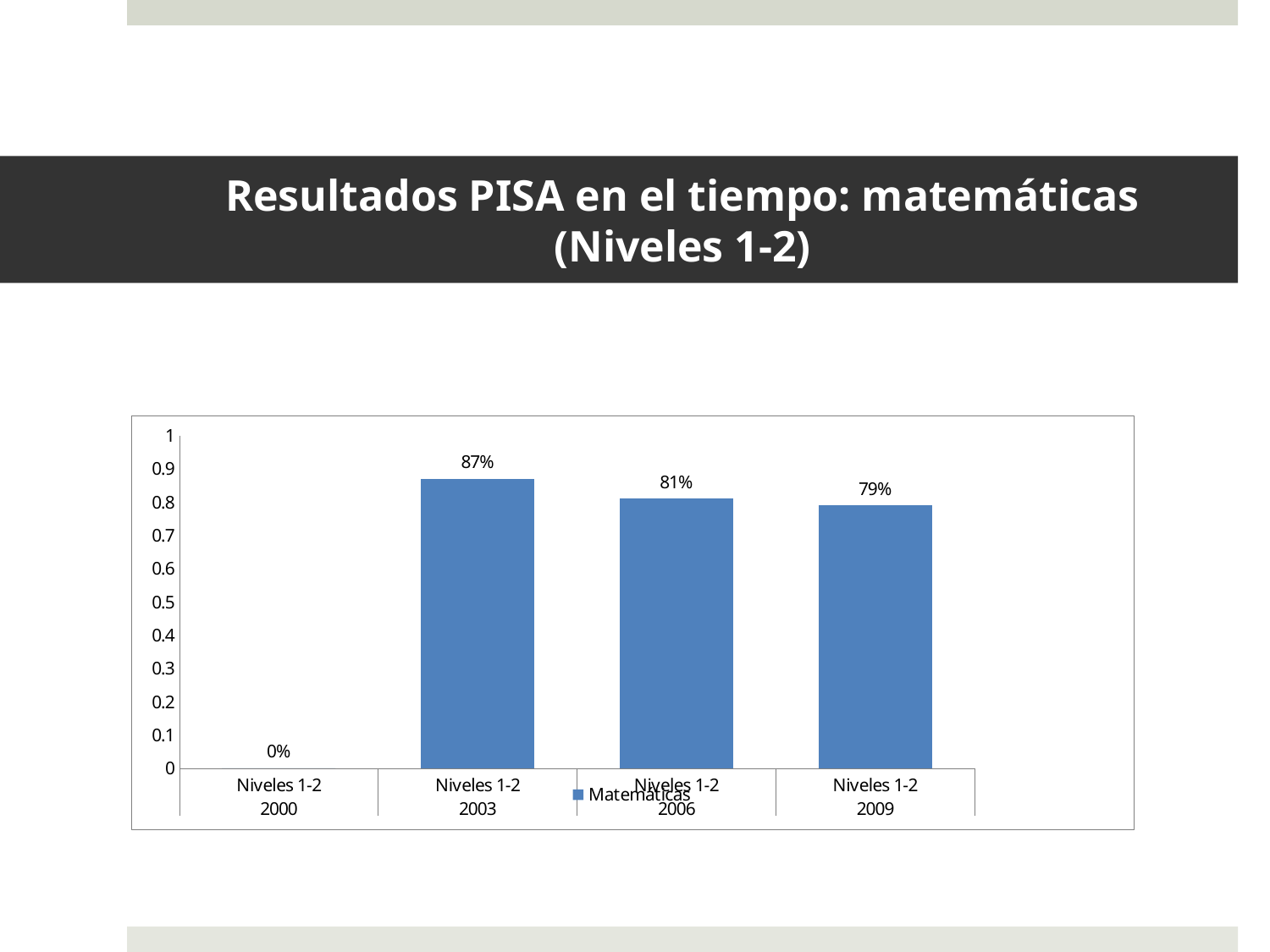
Which category has the lowest value? Niveles 1-2 2000 What is the value for Niveles 1-2 2009? 79% How many categories are shown on the x axis? 4 What is the value for Niveles 1-2 2003? 87% Which category has the highest value? Niveles 1-2 2003 What kind of chart is shown? bar chart How many series does the legend list? 1 Which is larger, the value for Niveles 1-2 2006 or Niveles 1-2 2009? Niveles 1-2 2006 Is the value for Niveles 1-2 2006 greater or less than 0.9? less Do the values rise or fall from Niveles 1-2 2003 to Niveles 1-2 2009? fall What is the value for Niveles 1-2 2000? 0% What is the difference between the values for Niveles 1-2 2003 and Niveles 1-2 2009? 8%